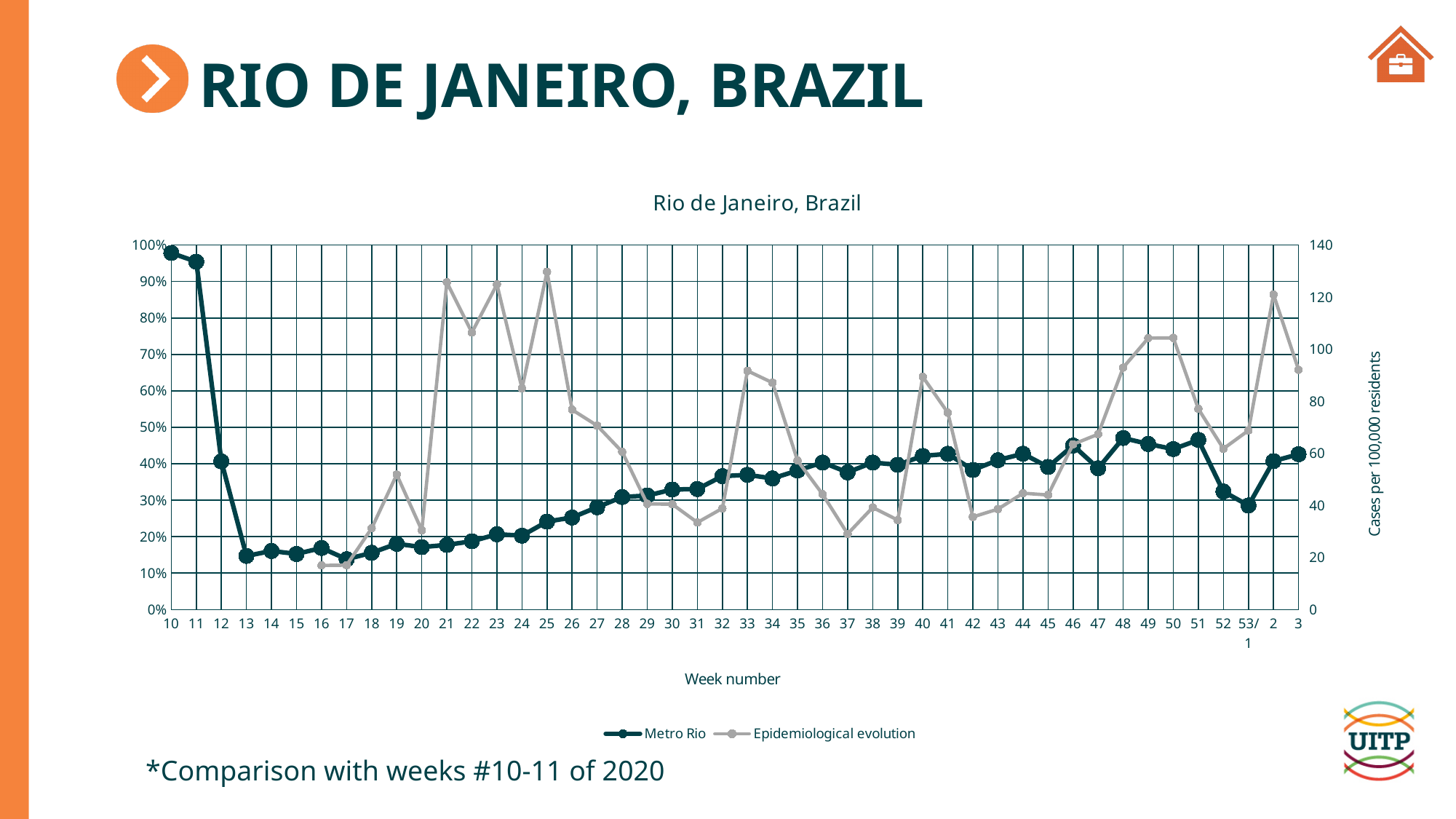
What kind of chart is shown on the slide? Line chart What is the label of the right-hand vertical axis? Cases per 100,000 residents How many series does the legend list? 2 Which is larger for the Metro Rio series: the value at week 46 or at week 52? Week 46 What is the label of the horizontal axis? Week number Is the Metro Rio value for week 52 greater or less than 40%? less Is the Metro Rio value for week 12 greater or less than 50%? less Is the Metro Rio value for week 10 greater or less than 90%? greater Does the Metro Rio series rise or fall from week 13 to week 28? Rise At which week is the Metro Rio series at its highest? Week 10